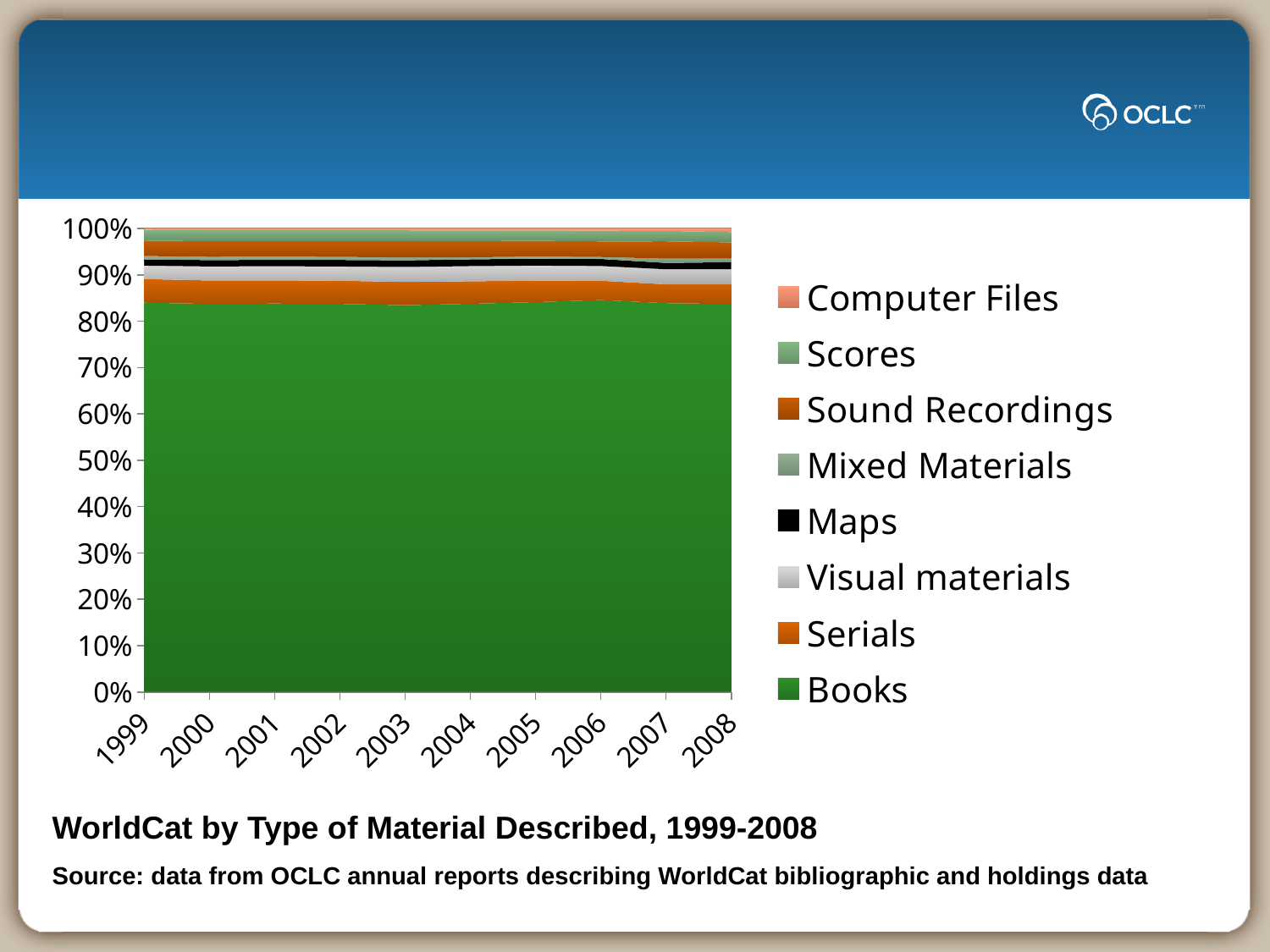
What is the last year shown on the x axis? 2008 What is the title of the chart? WorldCat by Type of Material Described, 1999-2008 Which type of material accounts for the largest share of WorldCat in every year shown? Books How many years are shown along the x axis? 10 Which is larger in 2008, the share for Books or the share for Serials? Books What is the highest value shown on the y axis? 100% What is the first year shown on the x axis? 1999 What kind of chart is shown on the slide? Stacked area chart Is the share for Books in 2008 greater or less than 90%? less Which series is shown in black in the legend? Maps Is the share for Books in 1999 greater or less than 80%? greater How many series does the legend list? 8